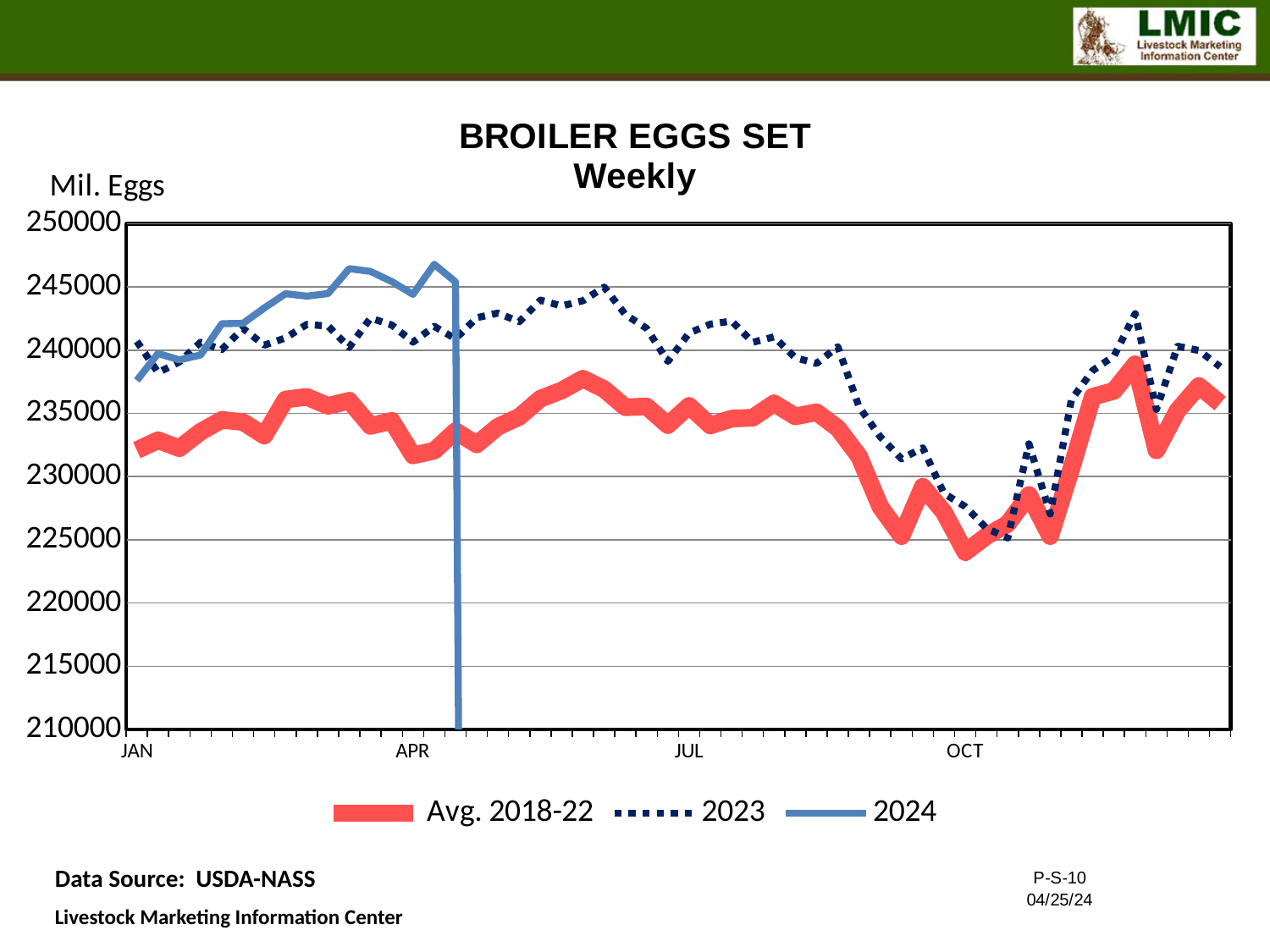
Is the peak value of the 2024 line in early April greater or less than 245000? greater In July, which series is higher: 2023 or Avg. 2018-22? 2023 Is the value of the Avg. 2018-22 line at the start of January greater or less than 235000? less How many series does the legend list? 3 What kind of chart is shown on the slide? line chart What is the title of the chart? BROILER EGGS SET Weekly Which series is the lowest in January? Avg. 2018-22 What unit label is shown on the vertical axis? Mil. Eggs Is the lowest value of the Avg. 2018-22 line, reached around October, greater or less than 225000? less Does the 2024 line generally rise or fall from January to April? rise In early April, which series is higher: 2024 or Avg. 2018-22? 2024